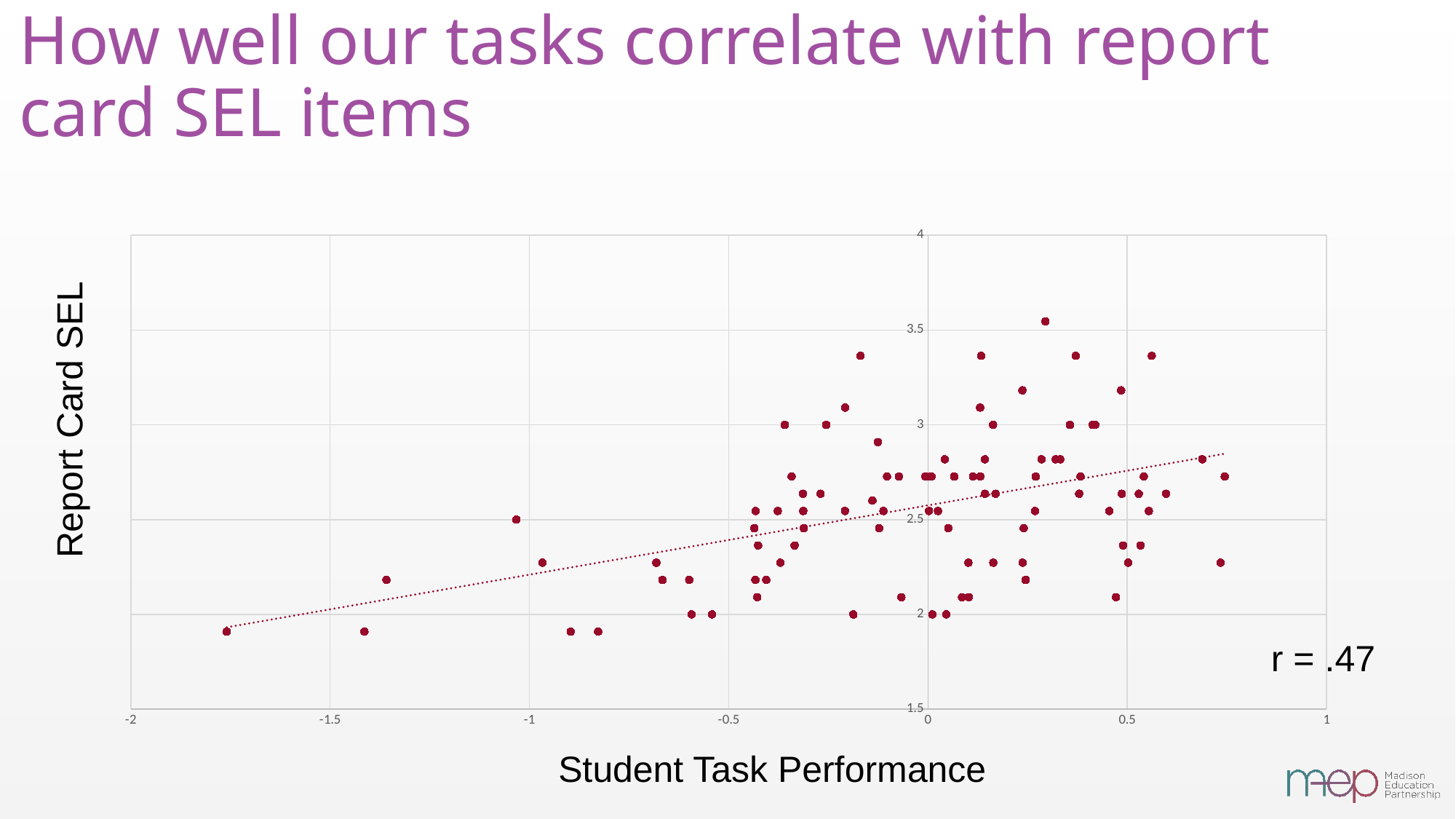
What is the label of the y axis? Report Card SEL What kind of chart is shown on the slide? Scatter plot Is the x value of the leftmost point greater or less than -1.5? less What is the label of the x axis? Student Task Performance What is the highest tick value shown on the y axis? 4 Do the Report Card SEL values tend to rise or fall as Student Task Performance increases along the x axis? Rise Is the Report Card SEL value of the lowest points on the chart greater or less than 2? less What is the lowest tick value shown on the x axis? -2 Is the Report Card SEL value of the highest point on the chart greater or less than 3? greater What correlation coefficient (r) is printed on the chart? r = .47